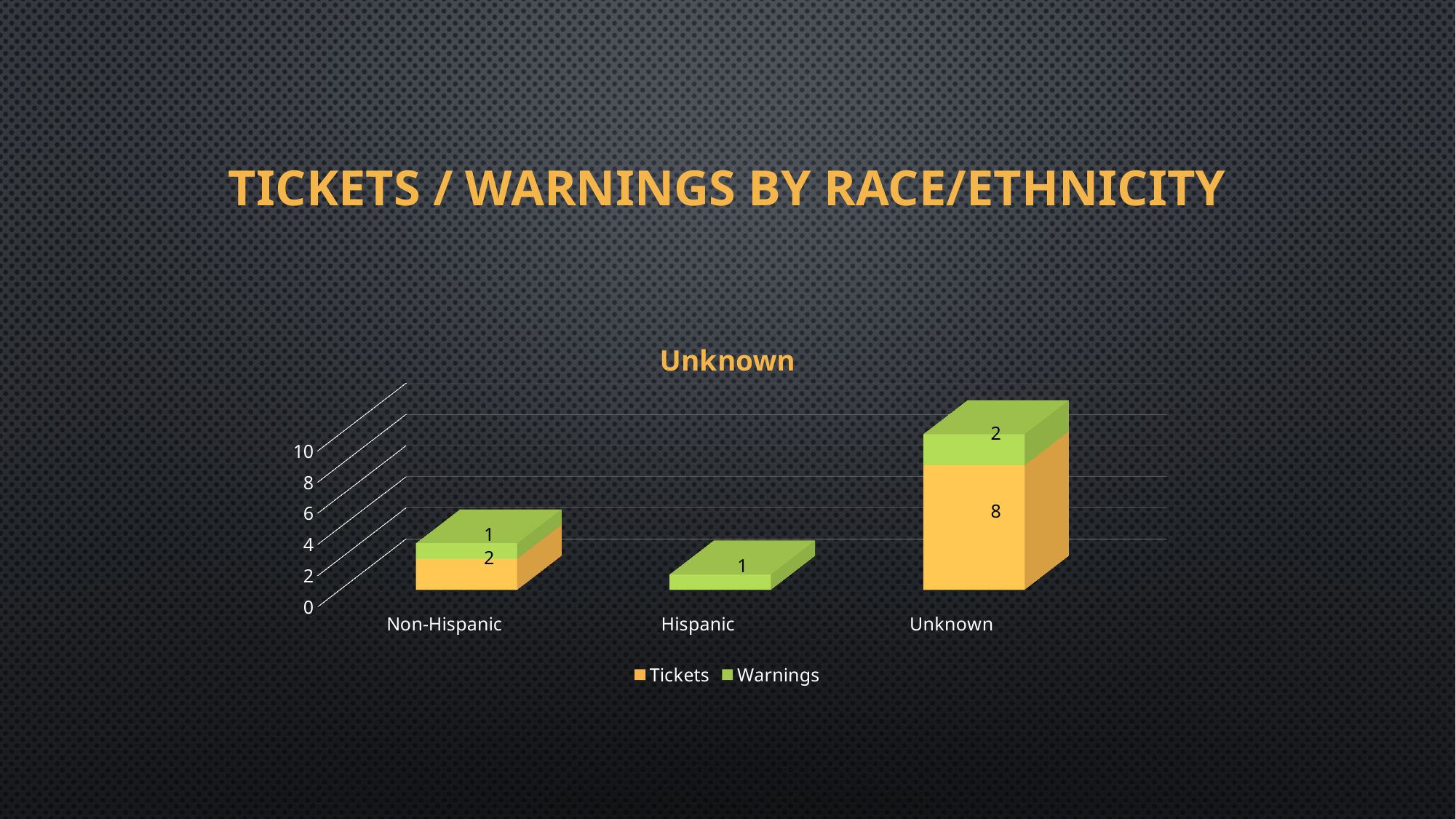
What is the Tickets value for Non-Hispanic? 2 How many series does the legend list? 2 What is the Warnings value for Non-Hispanic? 1 Which category has the highest Tickets value? Unknown What is the difference between the Tickets values for Unknown and Non-Hispanic? 6 What is the Warnings value for Hispanic? 1 What is the Tickets value for Unknown? 8 What is the total of the stacked bar for Unknown? 10 Which is larger, the Warnings value for Unknown or for Non-Hispanic? Unknown What is the Warnings value for Unknown? 2 What is the total of the stacked bar for Non-Hispanic? 3 How many categories are shown on the x axis? 3